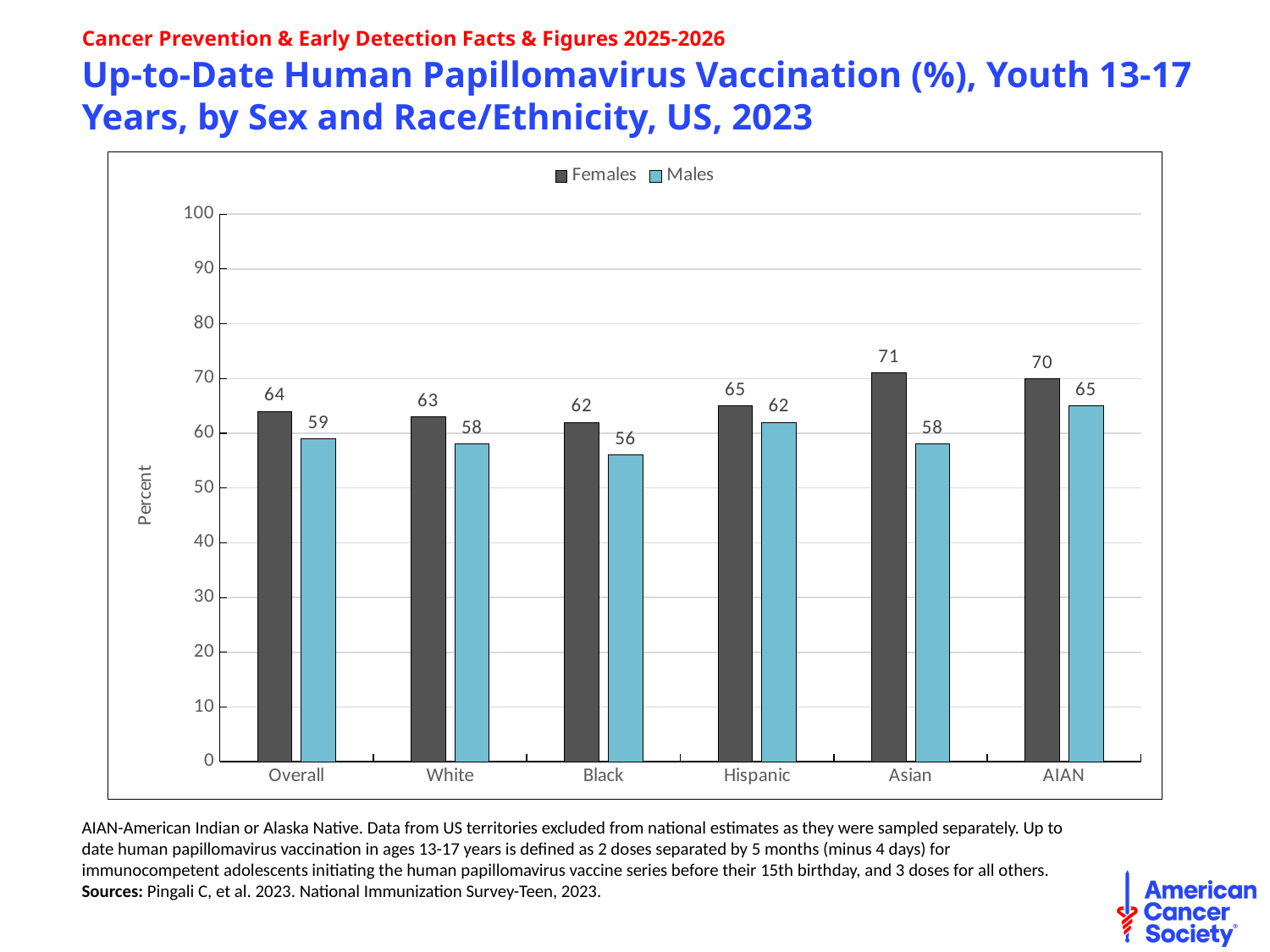
Which category has the lowest value for males? Black What is the value for Overall females? 64 Which is larger, the male value for AIAN or the male value for Hispanic? AIAN What is the difference between the female and male values for Asian youth? 13 What is the value for Black males? 56 How many race/ethnicity categories are shown on the x axis? 6 What is the up-to-date HPV vaccination percentage for Asian females? 71 What kind of chart is shown on the slide? bar chart What is the label on the y axis? Percent Which race/ethnicity category has the highest value for females? Asian Is the value for White males greater or less than 60? less How many series does the legend list? 2